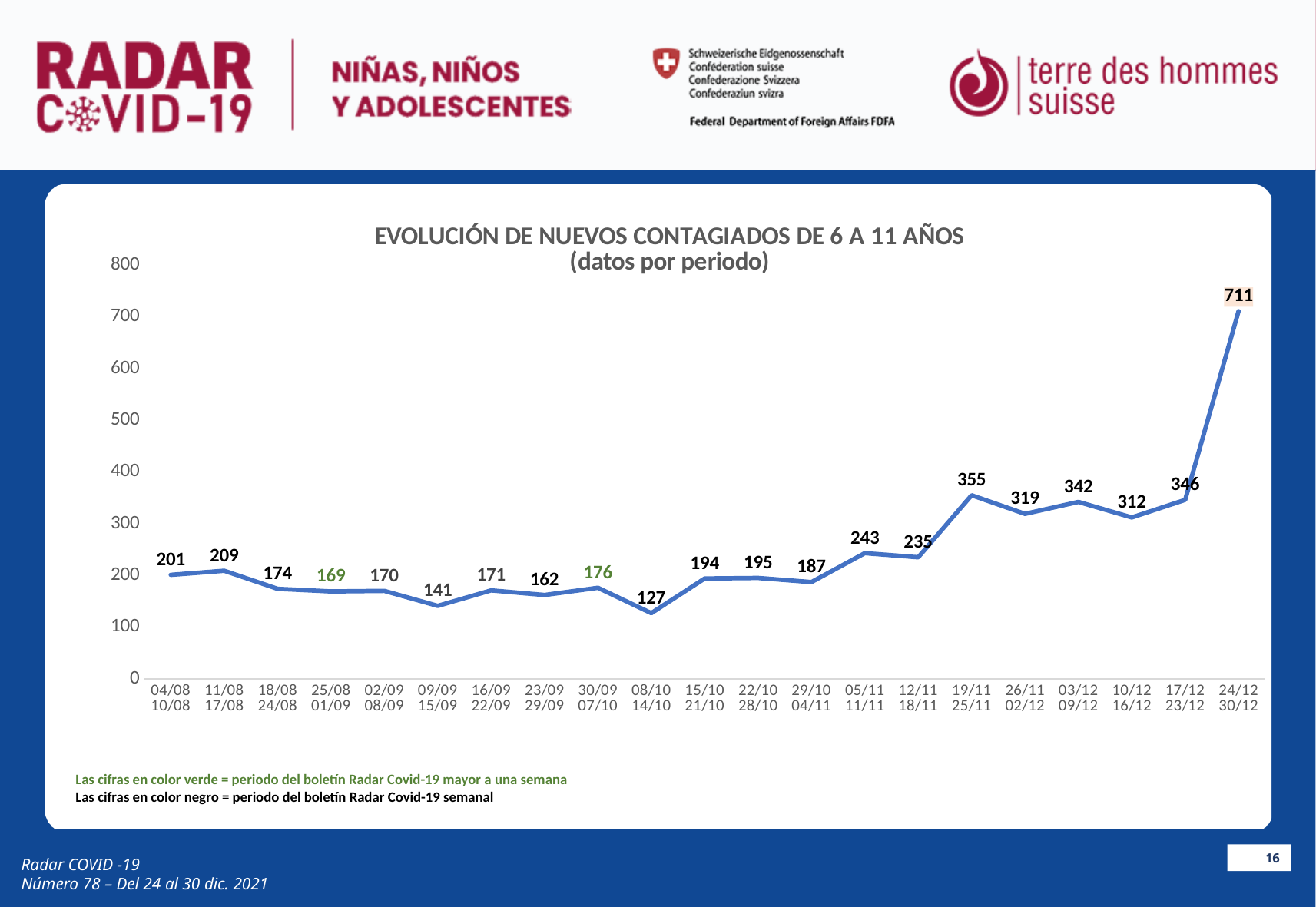
What is the value for the period 24/12–30/12? 711 What type of chart is shown on the slide? line chart What is the difference between the values for 24/12–30/12 and 17/12–23/12? 365 Which period has the highest value? 24/12–30/12 Which period has the lowest value? 08/10–14/10 What is the title of the chart? EVOLUCIÓN DE NUEVOS CONTAGIADOS DE 6 A 11 AÑOS (datos por periodo) What is the value for the period 19/11–25/11? 355 What is the value for the period 08/10–14/10? 127 How many data points are plotted on the chart? 21 Which two data labels are shown in green? 169 and 176 Which is larger, the value for 03/12–09/12 or the value for 10/12–16/12? 03/12–09/12 What is the difference between the values for 05/11–11/11 and 12/11–18/11? 8